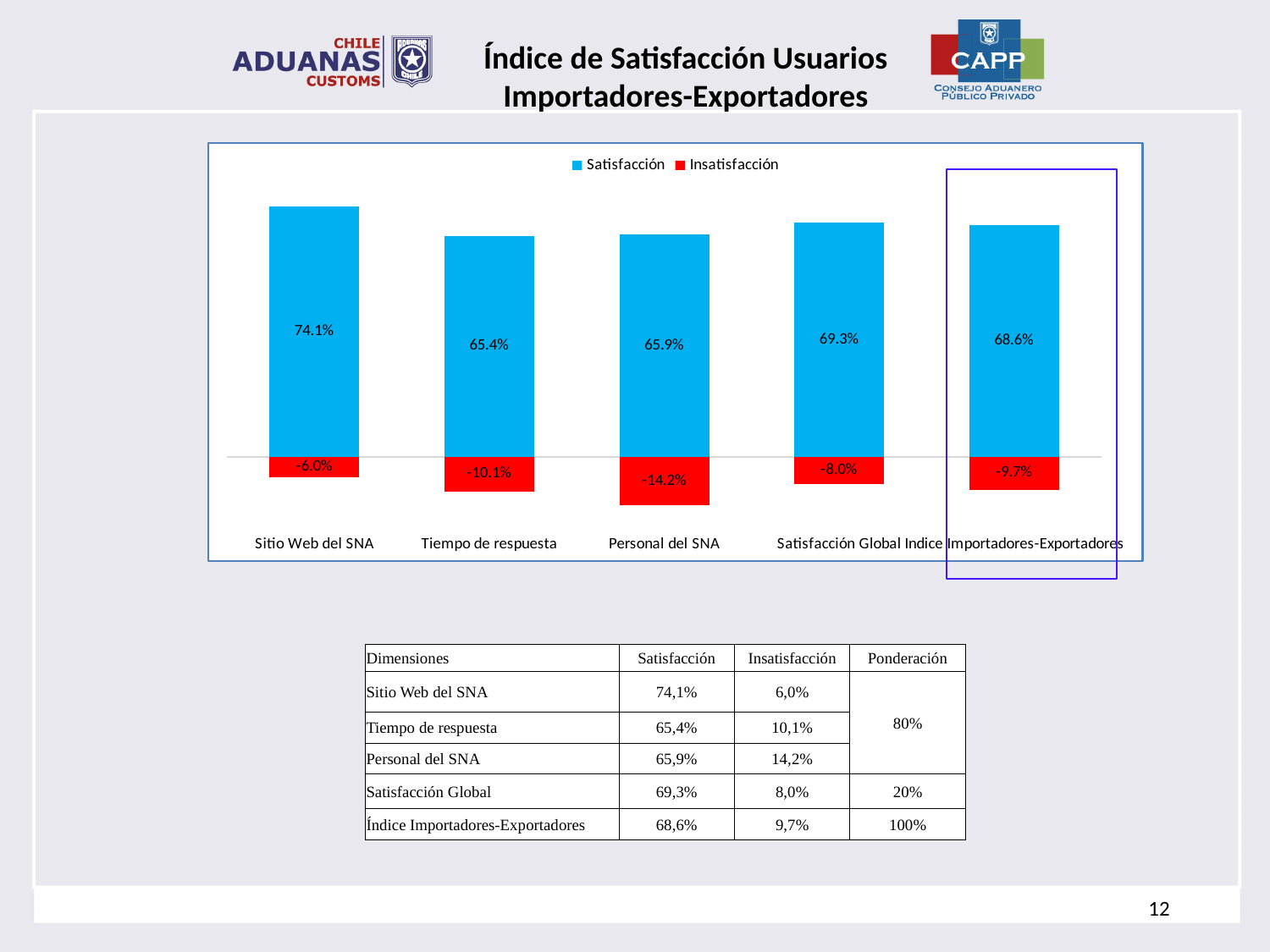
How many categories are shown on the x axis of the chart? 5 Which colour represents the Insatisfacción series in the chart? Red What is the Satisfacción value for Indice Importadores-Exportadores? 68.6% What is the difference between the Satisfacción values for Sitio Web del SNA and Tiempo de respuesta? 8.7% How many series does the chart legend list? 2 Which has a larger Satisfacción value, Satisfacción Global or Indice Importadores-Exportadores? Satisfacción Global What kind of chart is shown on the slide? Stacked bar chart Which category has the highest Satisfacción value? Sitio Web del SNA What is the Satisfacción value for Sitio Web del SNA? 74.1% What is the Insatisfacción value for Personal del SNA? -14.2% Which category has the lowest Satisfacción value? Tiempo de respuesta What is the Insatisfacción value for Satisfacción Global? -8.0%